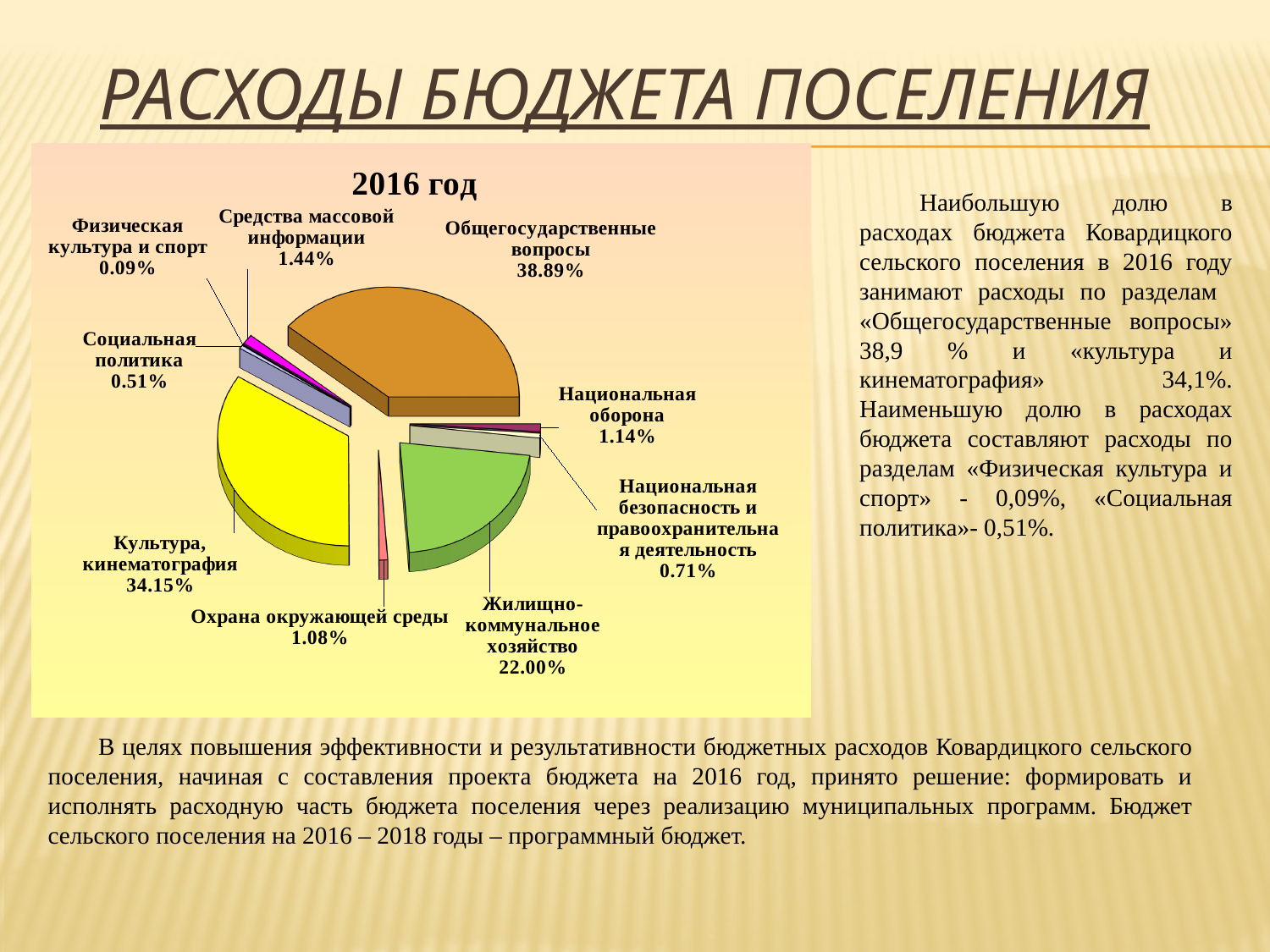
Which category has the smallest share of the pie? Физическая культура и спорт What kind of chart is shown on the slide? Pie chart What is the difference between the shares of "Общегосударственные вопросы" and "Культура, кинематография"? 4.74% Which is larger: "Средства массовой информации" or "Охрана окружающей среды"? Средства массовой информации What share of the pie does "Общегосударственные вопросы" take? 38.89% Which category has the largest share of the pie? Общегосударственные вопросы What is the value shown for "Жилищно-коммунальное хозяйство"? 22.00% How many categories are shown in the pie chart? 9 What is the title of the chart? 2016 год What is the value shown for "Национальная оборона"? 1.14% What is the value shown for "Социальная политика"? 0.51% What is the value shown for "Культура, кинематография"? 34.15%